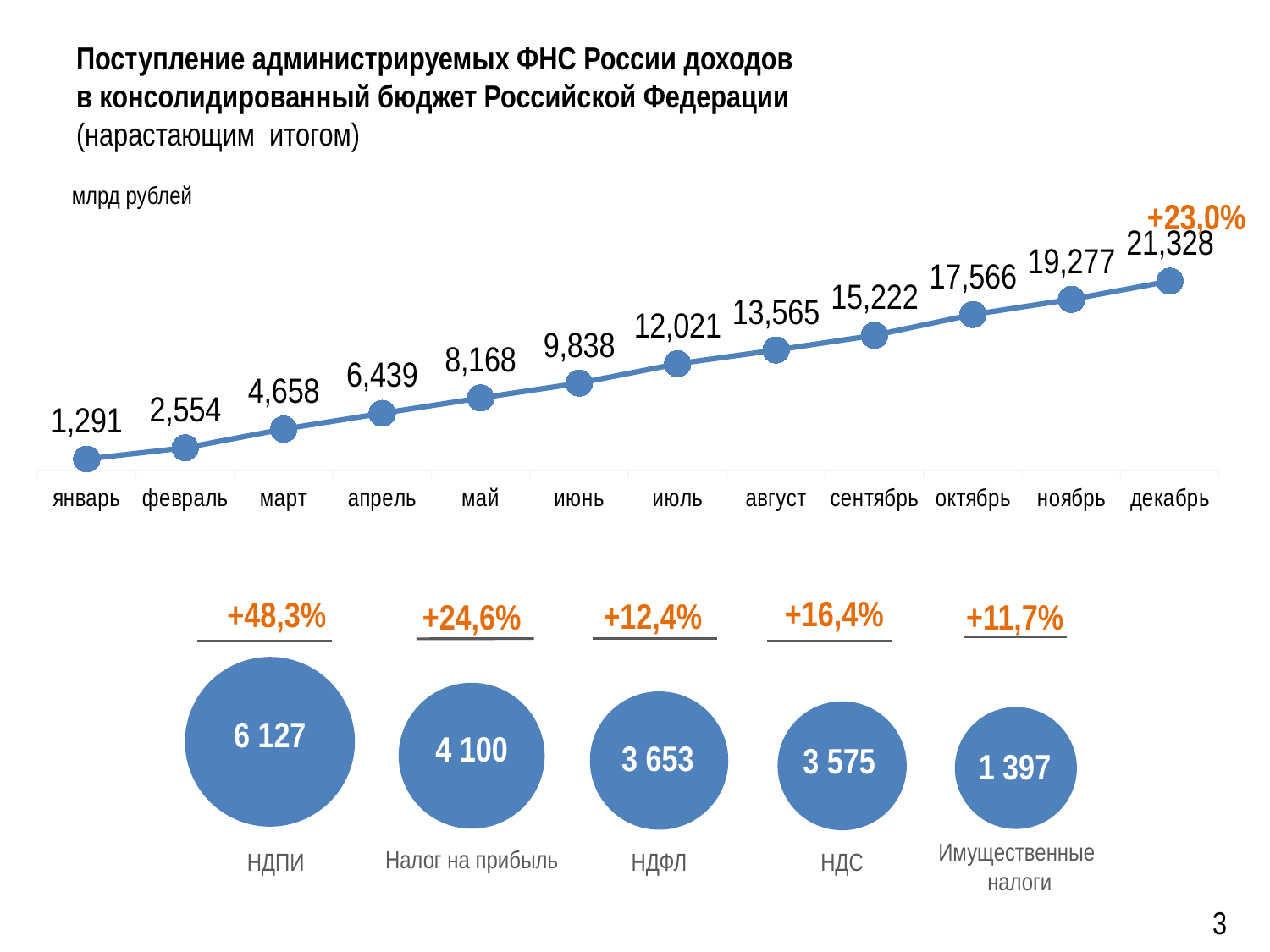
On the line chart at the top of the slide, what is the value for май? 8,168 On the line chart at the top of the slide, which is larger, the value for март or the value for апрель? апрель What kind of chart is shown at the top of the slide? line chart On the line chart at the top of the slide, do the values rise or fall from январь to декабрь? rise On the line chart at the top of the slide, what is the difference between the values for декабрь and ноябрь? 2,051 In the bubble chart at the bottom of the slide, what is the value shown for НДС? 3 575 On the line chart at the top of the slide, which month has the highest value? декабрь How many months are plotted on the line chart at the top of the slide? 12 On the line chart at the top of the slide, what is the value for сентябрь? 15,222 On the line chart at the top of the slide, which month has the lowest value? январь In the bubble chart at the bottom of the slide, which category has the largest value? НДПИ On the line chart at the top of the slide, what is the difference between the values for июль and июнь? 2,183